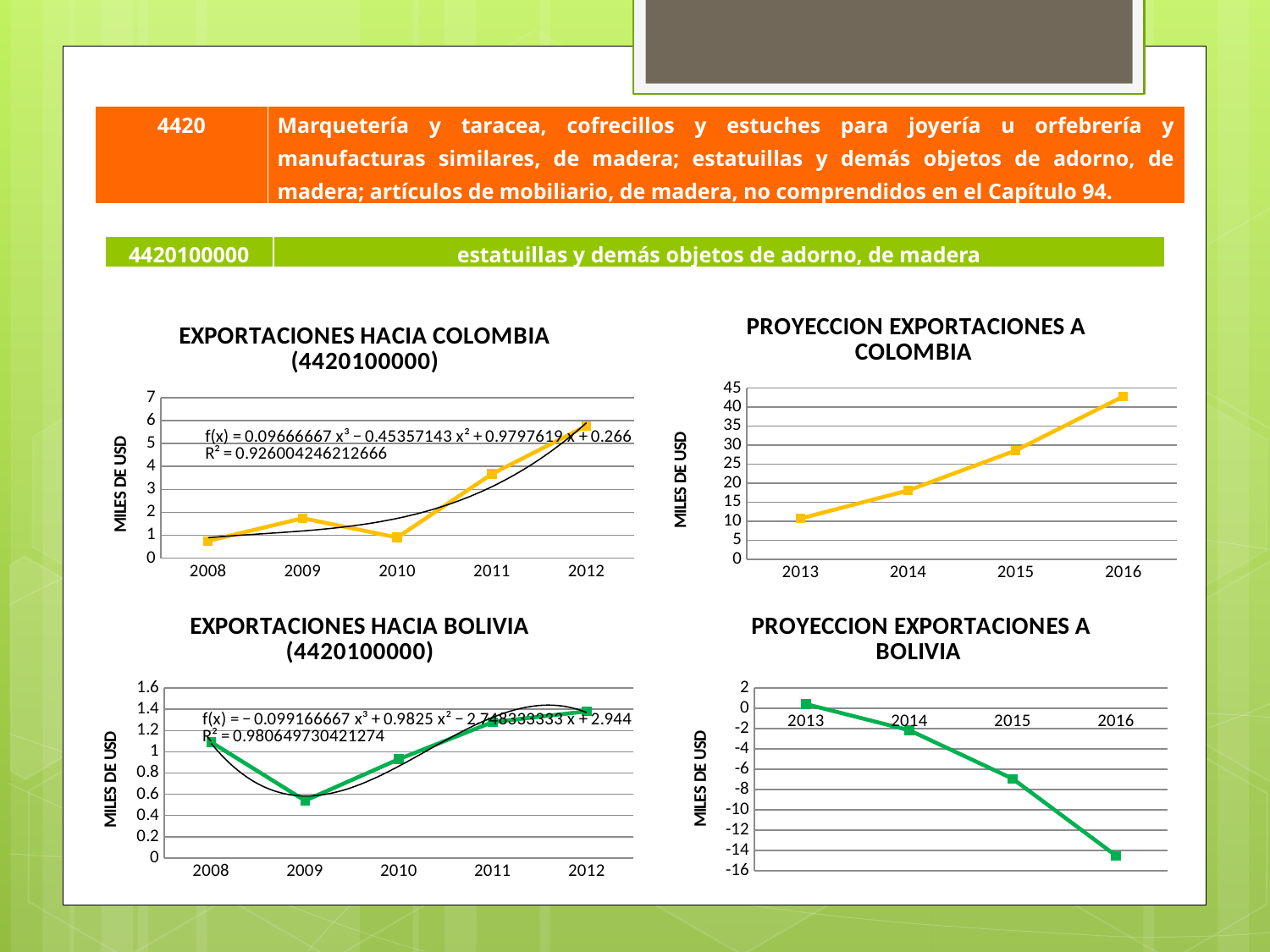
In the chart "EXPORTACIONES HACIA BOLIVIA (4420100000)", which year has the lowest value? 2009 In the chart "PROYECCION EXPORTACIONES A COLOMBIA", is the value for 2016 greater or less than 40? greater How many years are plotted in the chart "EXPORTACIONES HACIA COLOMBIA (4420100000)"? 5 What is the y-axis label of the chart "PROYECCION EXPORTACIONES A COLOMBIA"? MILES DE USD In the chart "EXPORTACIONES HACIA COLOMBIA (4420100000)", is the value for 2012 greater or less than 5? greater In the chart "EXPORTACIONES HACIA COLOMBIA (4420100000)", which year has the lowest value? 2008 What kind of chart is "EXPORTACIONES HACIA COLOMBIA (4420100000)"? line chart In the chart "EXPORTACIONES HACIA BOLIVIA (4420100000)", is the value for 2009 greater or less than 0.8? less In the chart "PROYECCION EXPORTACIONES A BOLIVIA", do the values rise or fall from 2013 to 2016? fall In the chart "PROYECCION EXPORTACIONES A COLOMBIA", do the values rise or fall from 2013 to 2016? rise In the chart "EXPORTACIONES HACIA COLOMBIA (4420100000)", which year has the highest value? 2012